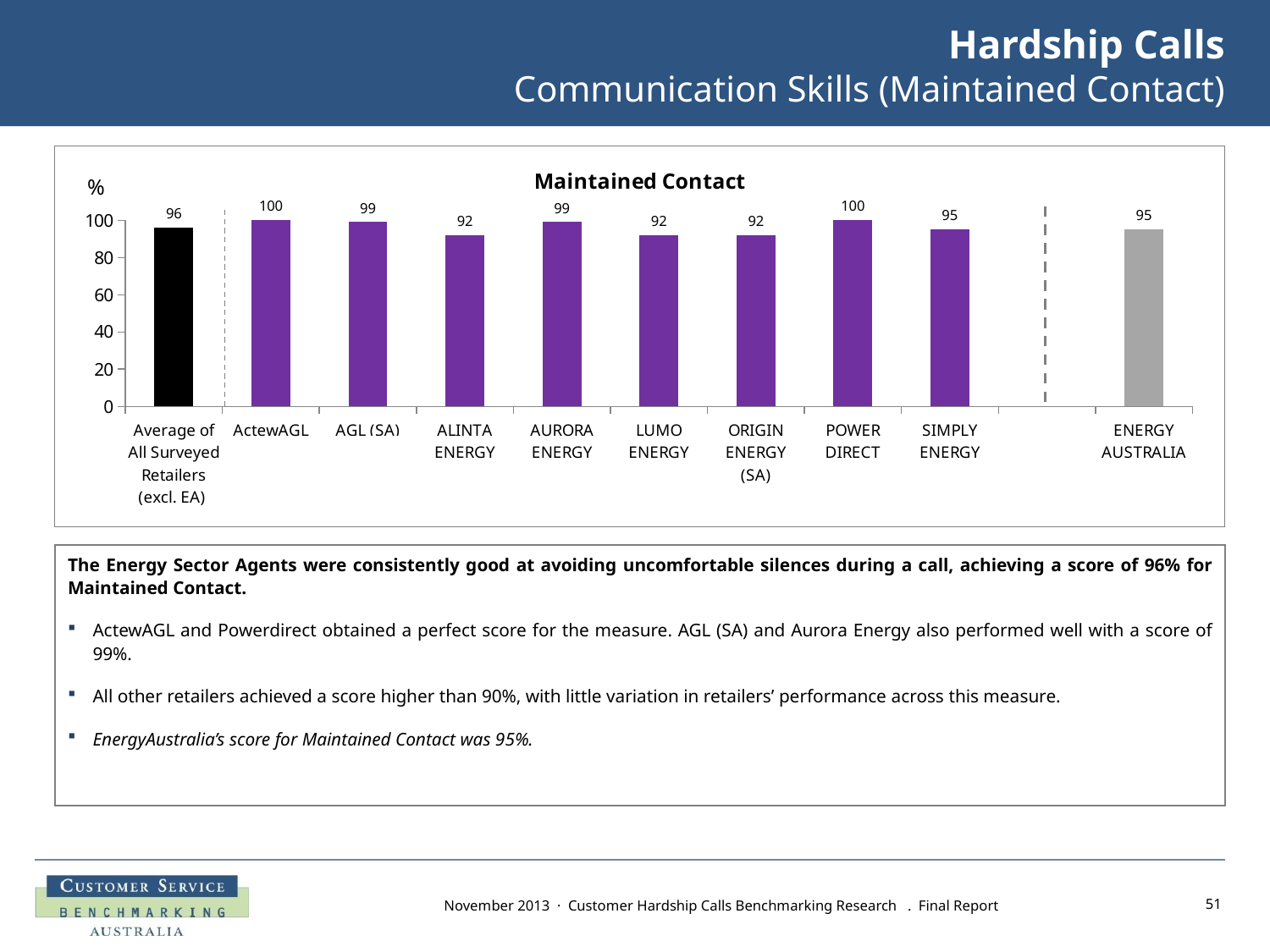
What is the value for ActewAGL in the Maintained Contact chart? 100 What is the title of the chart on the slide? Maintained Contact What is the lowest value shown in the Maintained Contact chart? 92 How many bars are shown in the Maintained Contact chart? 10 Which is larger, the value for SIMPLY ENERGY or the value for ORIGIN ENERGY (SA)? SIMPLY ENERGY Is the value for AURORA ENERGY greater or less than 80? greater What kind of chart is shown on the slide? Bar chart What is the value for ALINTA ENERGY in the Maintained Contact chart? 92 Which retailers have the highest value in the Maintained Contact chart? ActewAGL and POWER DIRECT What is the difference between the values for AGL (SA) and LUMO ENERGY? 7 What is the value for the Average of All Surveyed Retailers (excl. EA)? 96 What is the value for ENERGY AUSTRALIA in the Maintained Contact chart? 95